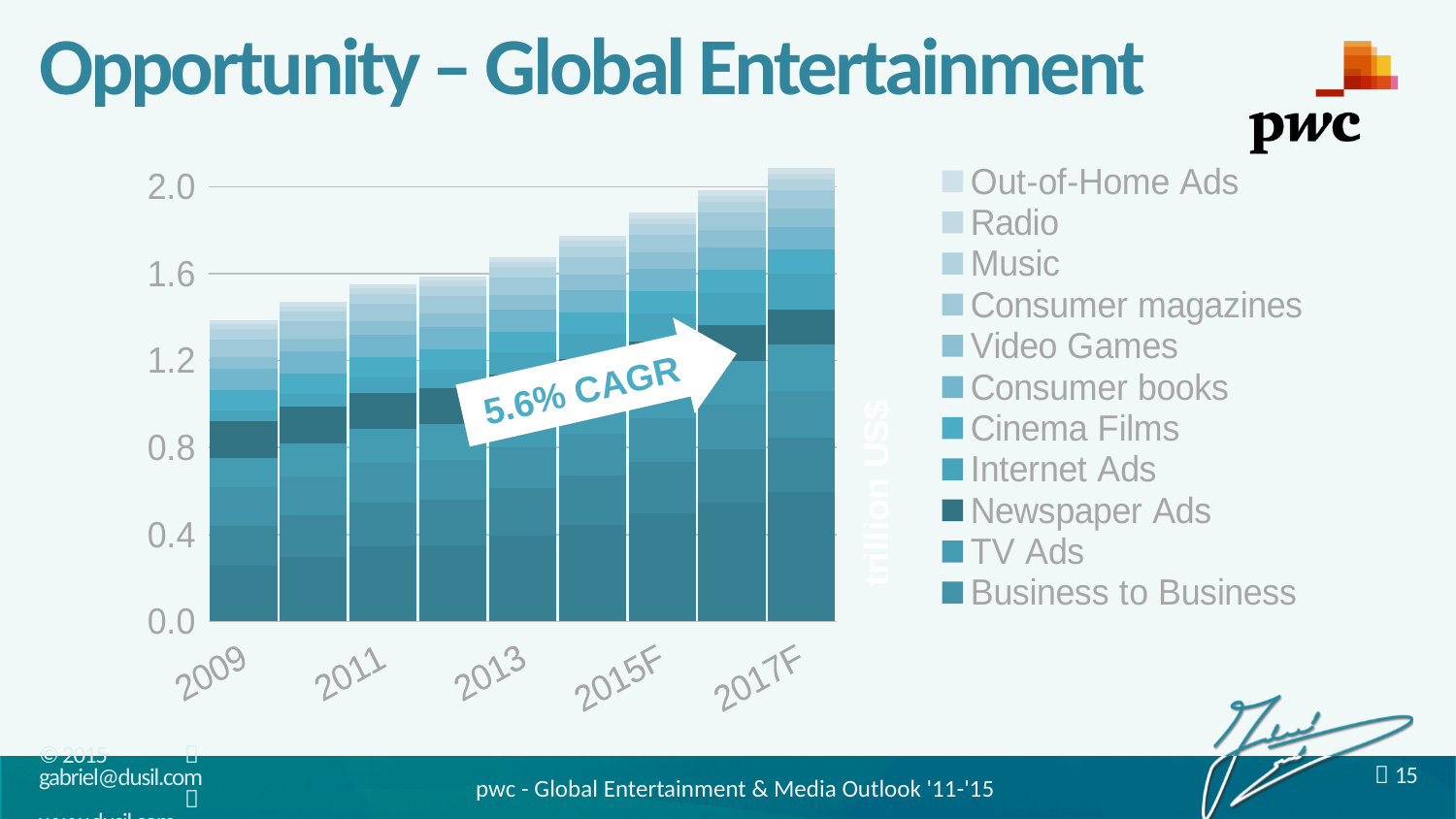
What is the first entry listed in the chart legend? Out-of-Home Ads Is the total value for 2017F greater or less than 1.6? greater Do the stacked bar totals rise or fall from 2009 to 2017F? rise Which year has the shortest stacked bar? 2009 What kind of chart is shown on the slide? stacked bar chart What growth rate is written on the arrow annotation in the chart? 5.6% CAGR How many bars are plotted in the chart? 9 Is the total value for 2009 greater or less than 1.6? less Is the total value for 2015F greater or less than 1.6? greater Which has the larger total, 2009 or 2017F? 2017F How many series does the chart legend list? 11 Which year has the tallest stacked bar? 2017F